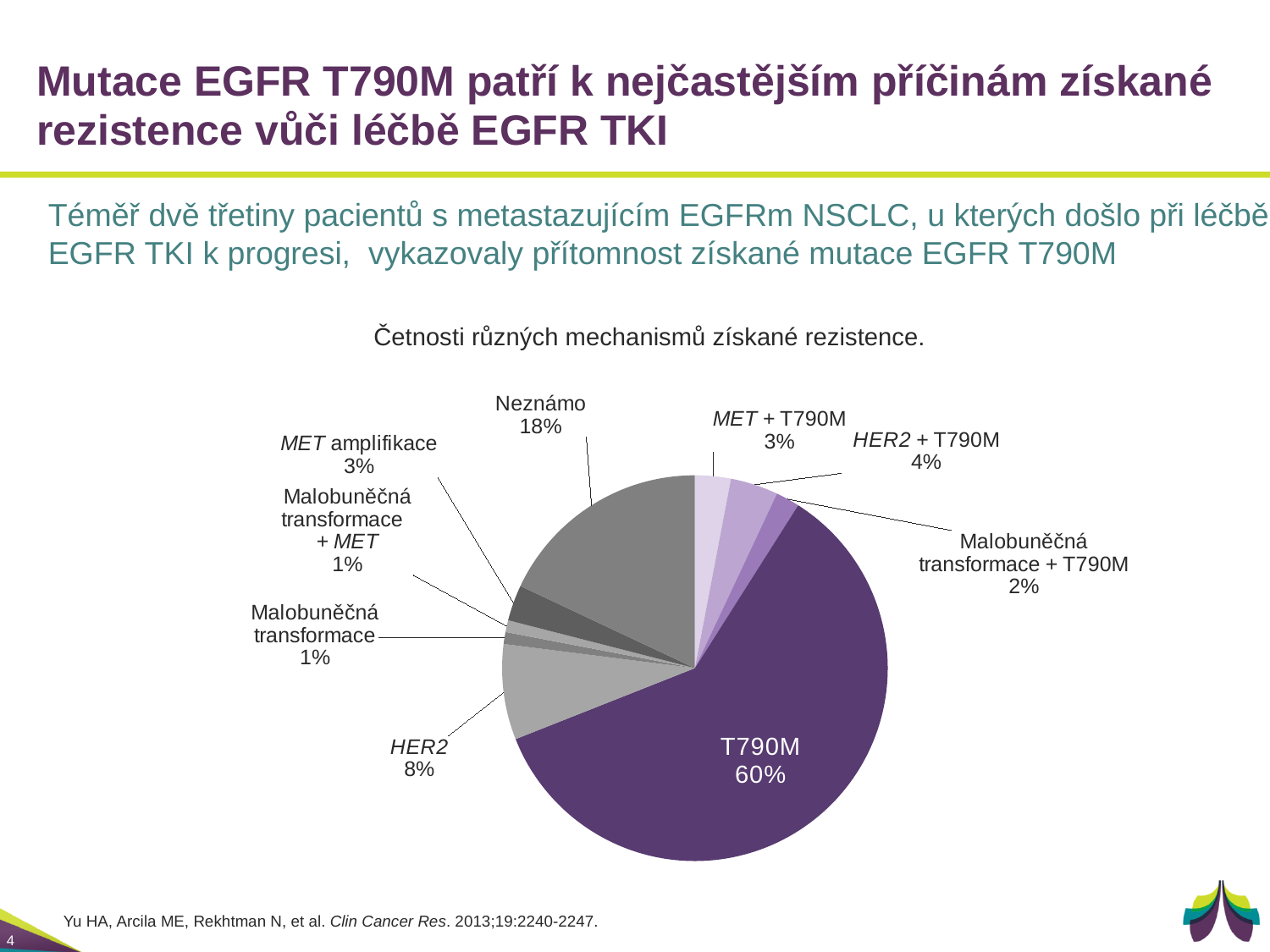
What percentage is shown for Neznámo? 18% What is the difference in percentage points between T790M and Neznámo? 42 What is the value for HER2 + T790M? 4% What kind of chart is shown on the slide? Pie chart What share of the pie does T790M account for? 60% How many slices does the pie chart have? 9 Which is larger, the slice for HER2 or the slice for MET amplifikace? HER2 What percentage is shown for Malobuněčná transformace + T790M? 2% What is the title of the chart? Četnosti různých mechanismů získané rezistence. What is the combined share of MET + T790M and HER2 + T790M? 7% What colour is the T790M slice? Purple Which category has the largest slice of the pie? T790M